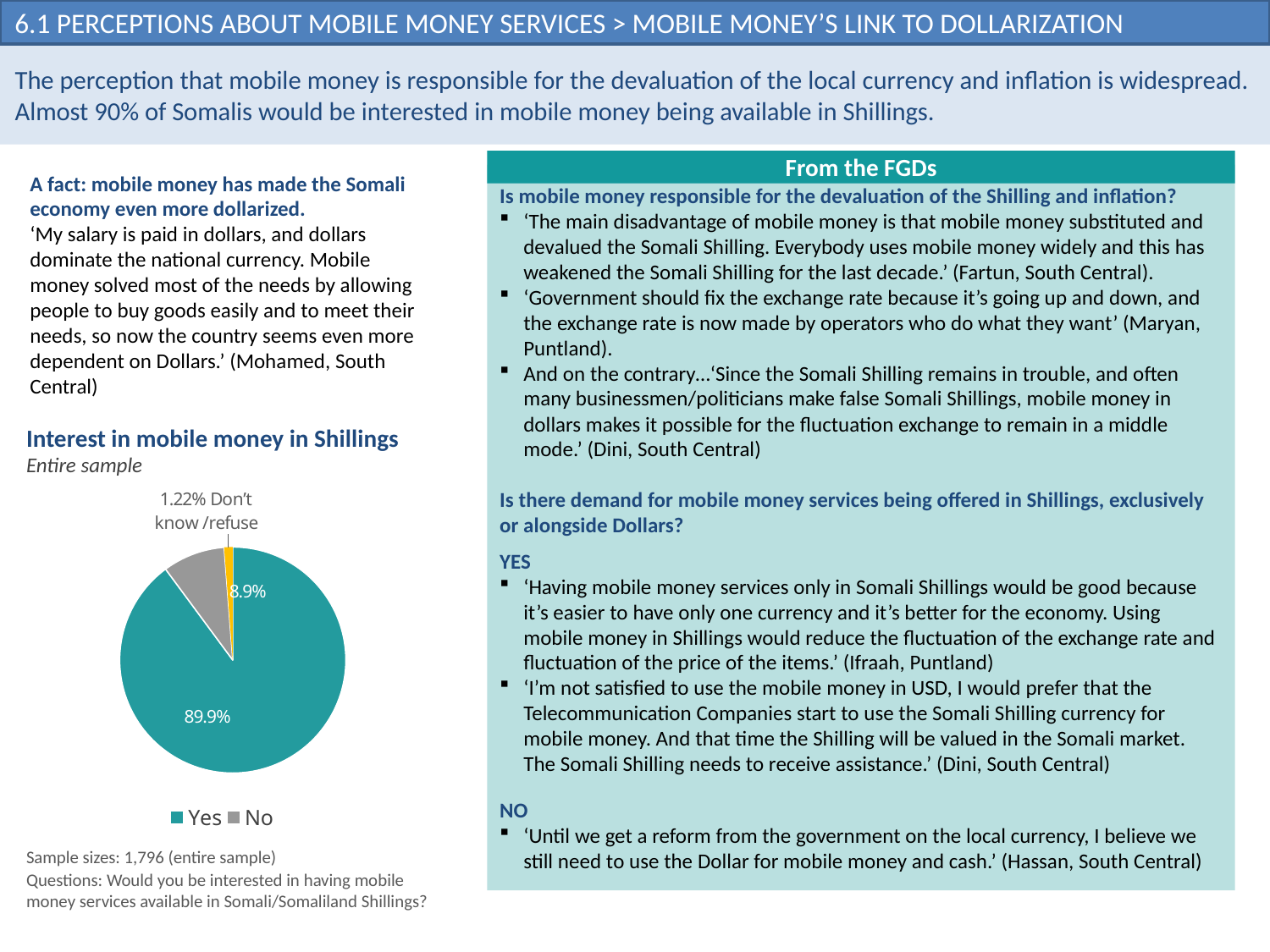
In the 'Interest in mobile money in Shillings' pie chart, by how many percentage points does the Yes share exceed the No share? 81.0 percentage points In the 'Interest in mobile money in Shillings' pie chart, what share of respondents answered No? 8.9% How many entries does the legend of the 'Interest in mobile money in Shillings' pie chart list? 2 Which slice is the largest in the 'Interest in mobile money in Shillings' pie chart? Yes What colour is the Yes slice in the 'Interest in mobile money in Shillings' pie chart? Teal In the 'Interest in mobile money in Shillings' pie chart, which is larger: the Yes slice or the No slice? Yes In the 'Interest in mobile money in Shillings' pie chart, what share of respondents answered Yes? 89.9% What sample size is stated below the 'Interest in mobile money in Shillings' pie chart? 1,796 (entire sample) Which slice is the smallest in the 'Interest in mobile money in Shillings' pie chart? Don't know/refuse What kind of chart is shown under the heading 'Interest in mobile money in Shillings'? Pie chart How many slices does the 'Interest in mobile money in Shillings' pie chart have? 3 In the 'Interest in mobile money in Shillings' pie chart, what share of respondents answered Don't know/refuse? 1.22%